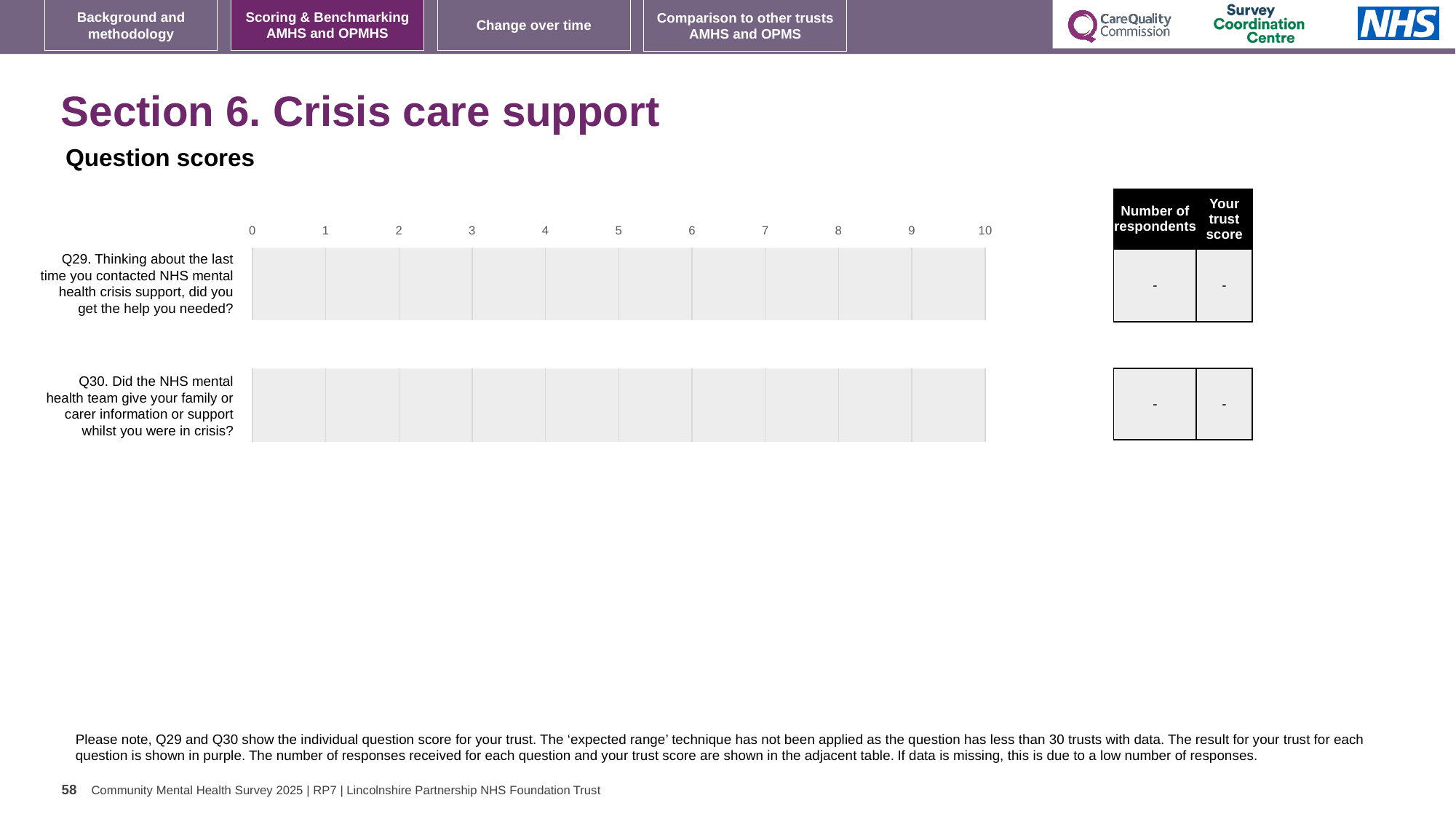
What kind of chart is used for the question scores on this slide? bar chart Which question label on the chart begins 'Did the NHS mental health team give your family or carer information or support'? Q30 What is the 'Number of respondents' shown for Q30 in the table next to the chart? - What is the 'Your trust score' shown for Q30 in the table next to the chart? - What is the 'Your trust score' shown for Q29 in the table next to the chart? - What is the highest value shown on the x axis of the question scores chart? 10 How many questions (categories) are listed on the question scores chart? 2 What is the lowest value shown on the x axis of the question scores chart? 0 What is the 'Number of respondents' shown for Q29 in the table next to the chart? -